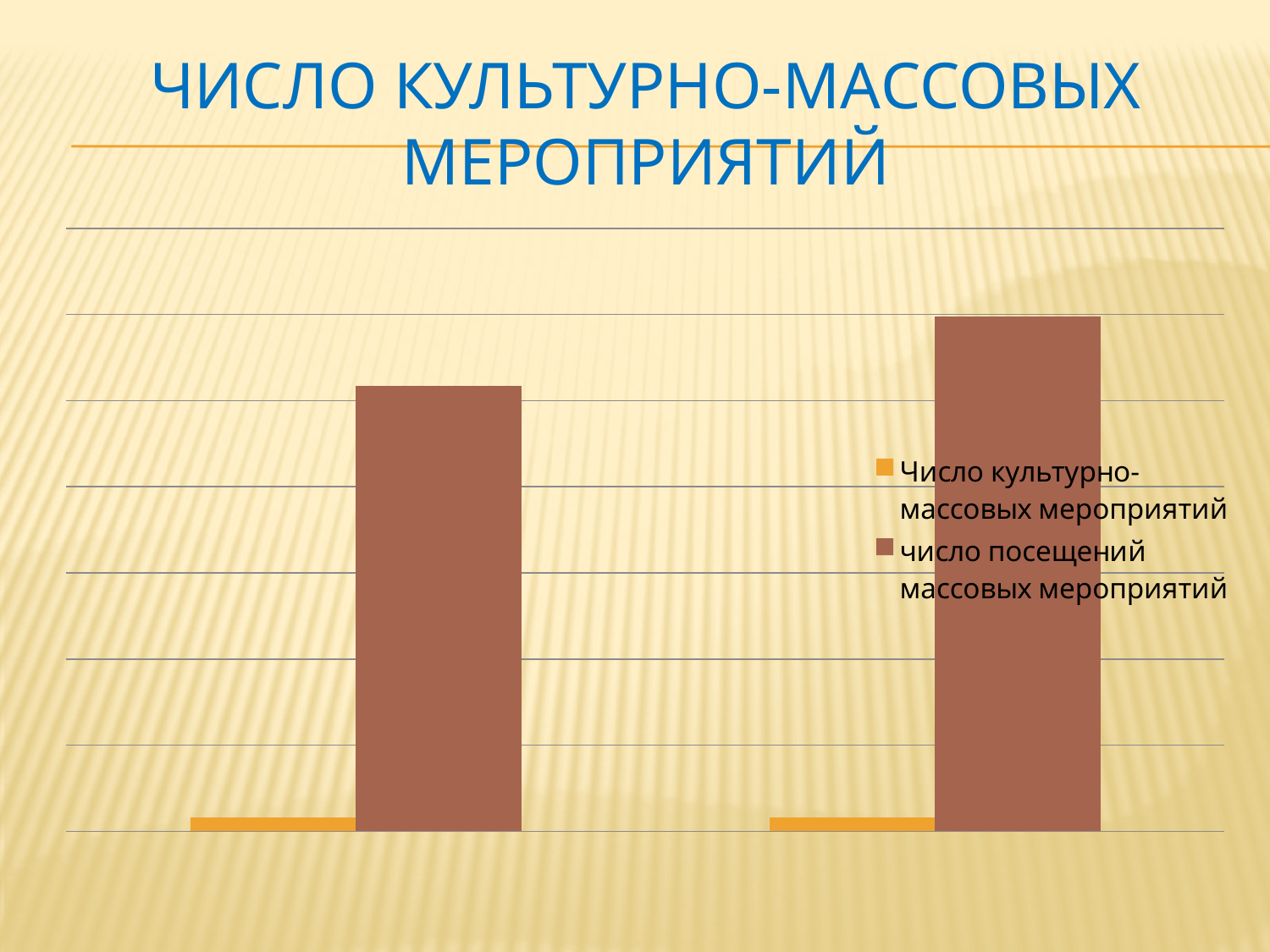
What is the title of the chart on the slide? ЧИСЛО КУЛЬТУРНО-МАССОВЫХ МЕРОПРИЯТИЙ Which series is shown in brown in the legend? число посещений массовых мероприятий Which series has the taller bars, 'Число культурно-массовых мероприятий' or 'число посещений массовых мероприятий'? число посещений массовых мероприятий How many groups of bars are plotted in the chart? 2 For the series 'число посещений массовых мероприятий', is the left bar or the right bar taller? the right bar How many series does the legend list? 2 Which series has the lowest bars in the chart? Число культурно-массовых мероприятий Do the values for 'число посещений массовых мероприятий' rise or fall from the left group to the right group? rise What kind of chart is shown on the slide? bar chart